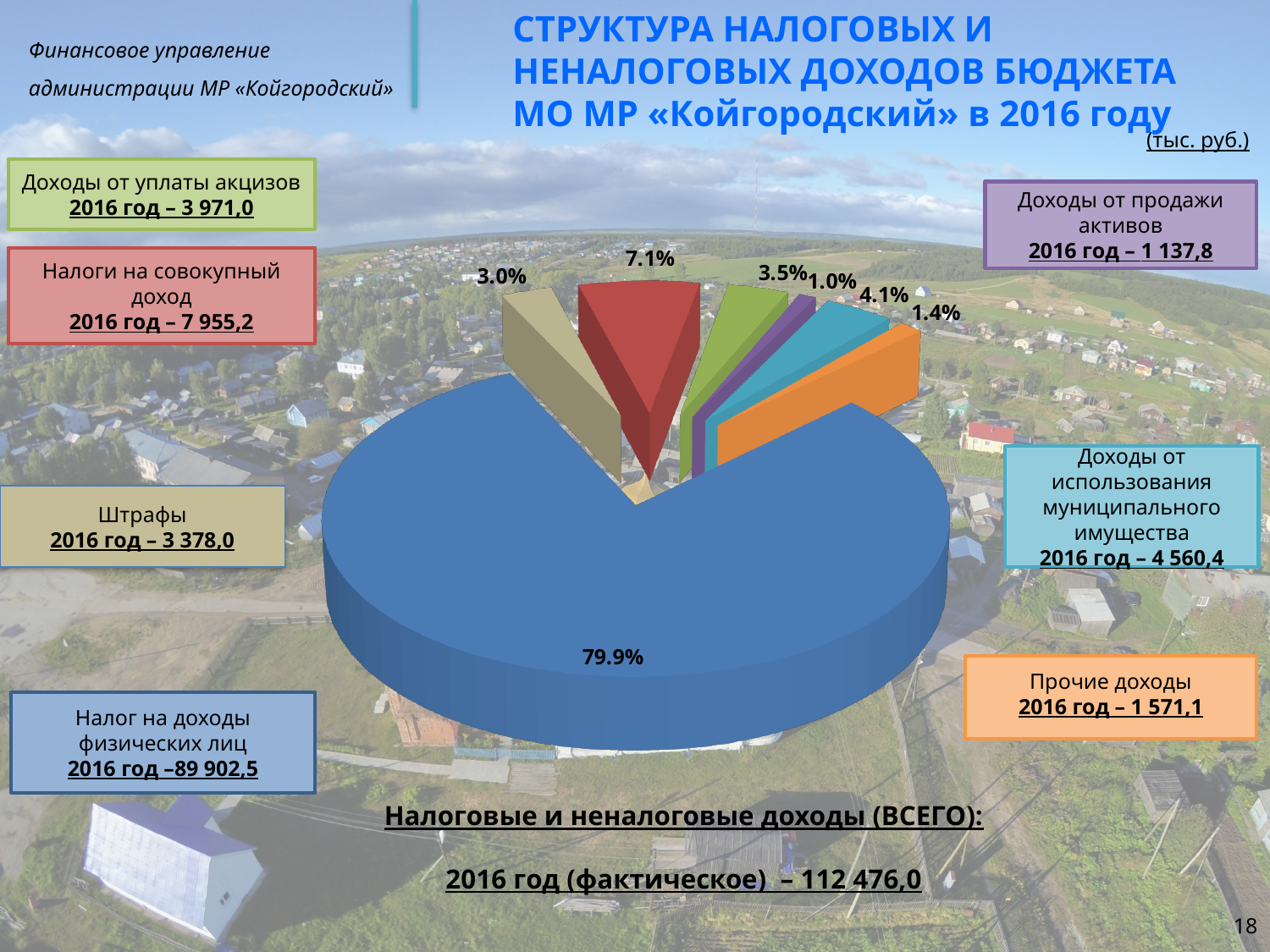
What percentage is shown for the red slice (Налоги на совокупный доход)? 7.1% Which category has the smallest share of the pie? Доходы от продажи активов What is the difference in percentage points between the Налоги на совокупный доход slice (7.1%) and the Штрафы slice (3.0%)? 4.1 What percentage is shown for the slice Доходы от использования муниципального имущества? 4.1% How many slices does the pie chart have? 7 What share of the pie does the largest slice (Налог на доходы физических лиц) take? 79.9% What is the 2016 value for Штрафы shown on the slide? 3 378,0 What kind of chart is shown on the slide? pie chart What is the 2016 value for Доходы от уплаты акцизов? 3 971,0 What is the total of tax and non-tax revenues (ВСЕГО) for 2016 shown on the slide? 112 476,0 Which category has the largest share of the pie? Налог на доходы физических лиц Which slice is larger: Прочие доходы or Доходы от уплаты акцизов? Доходы от уплаты акцизов